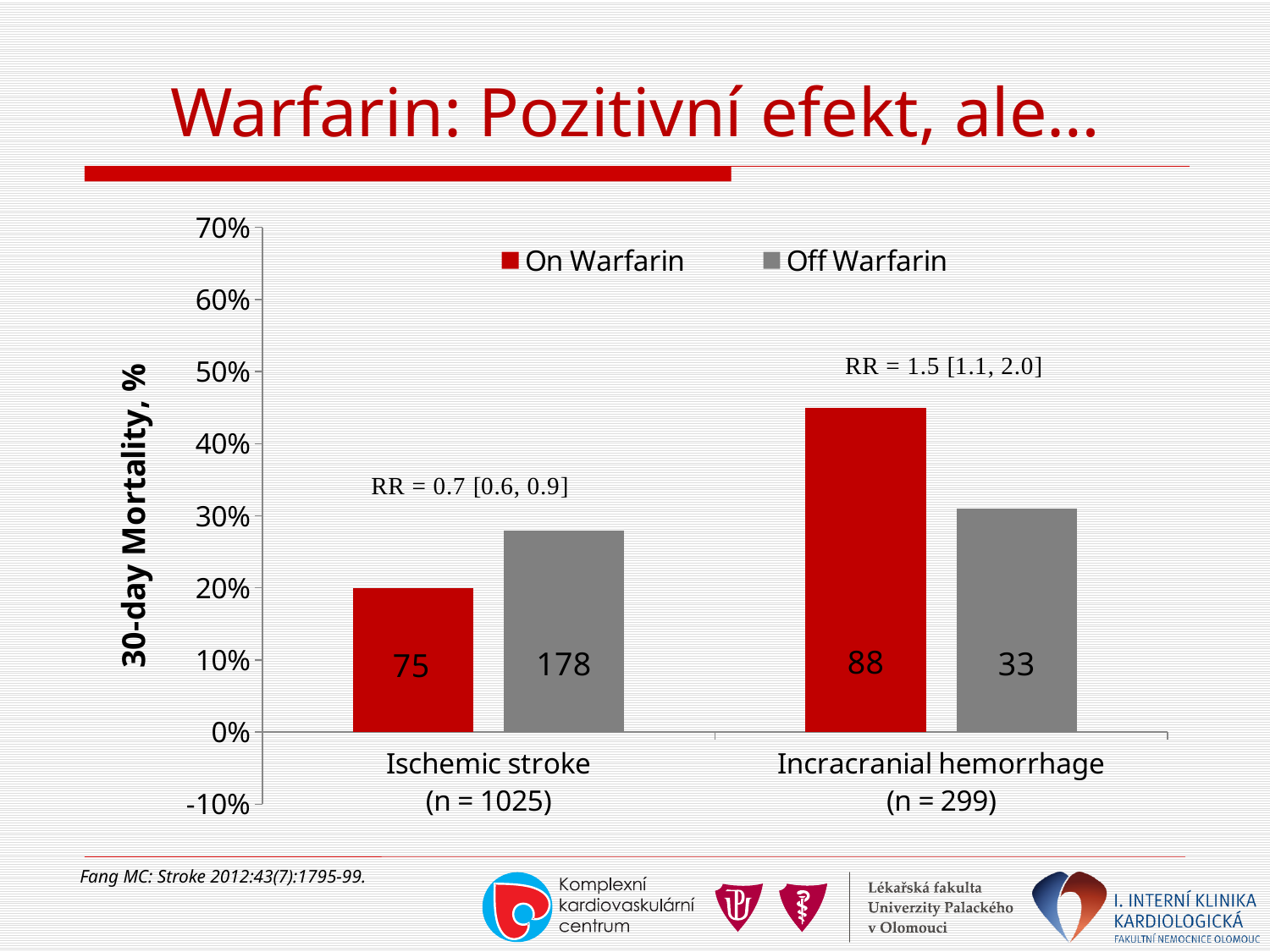
How many categories are shown on the x axis? 2 What number is printed inside the Off Warfarin bar for Incracranial hemorrhage? 33 Which bar is the shortest in the chart? On Warfarin, Ischemic stroke What RR value is annotated above the Ischemic stroke bars? RR = 0.7 [0.6, 0.9] What kind of chart is shown on the slide? bar chart Which bar is the tallest in the chart? On Warfarin, Incracranial hemorrhage Is the 30-day mortality for On Warfarin in Incracranial hemorrhage greater or less than 40%? greater What number is printed inside the Off Warfarin bar for Ischemic stroke? 178 What number is printed inside the On Warfarin bar for Ischemic stroke? 75 How many series does the legend list? 2 For Incracranial hemorrhage, is the 30-day mortality higher On Warfarin or Off Warfarin? On Warfarin What number is printed inside the On Warfarin bar for Incracranial hemorrhage? 88